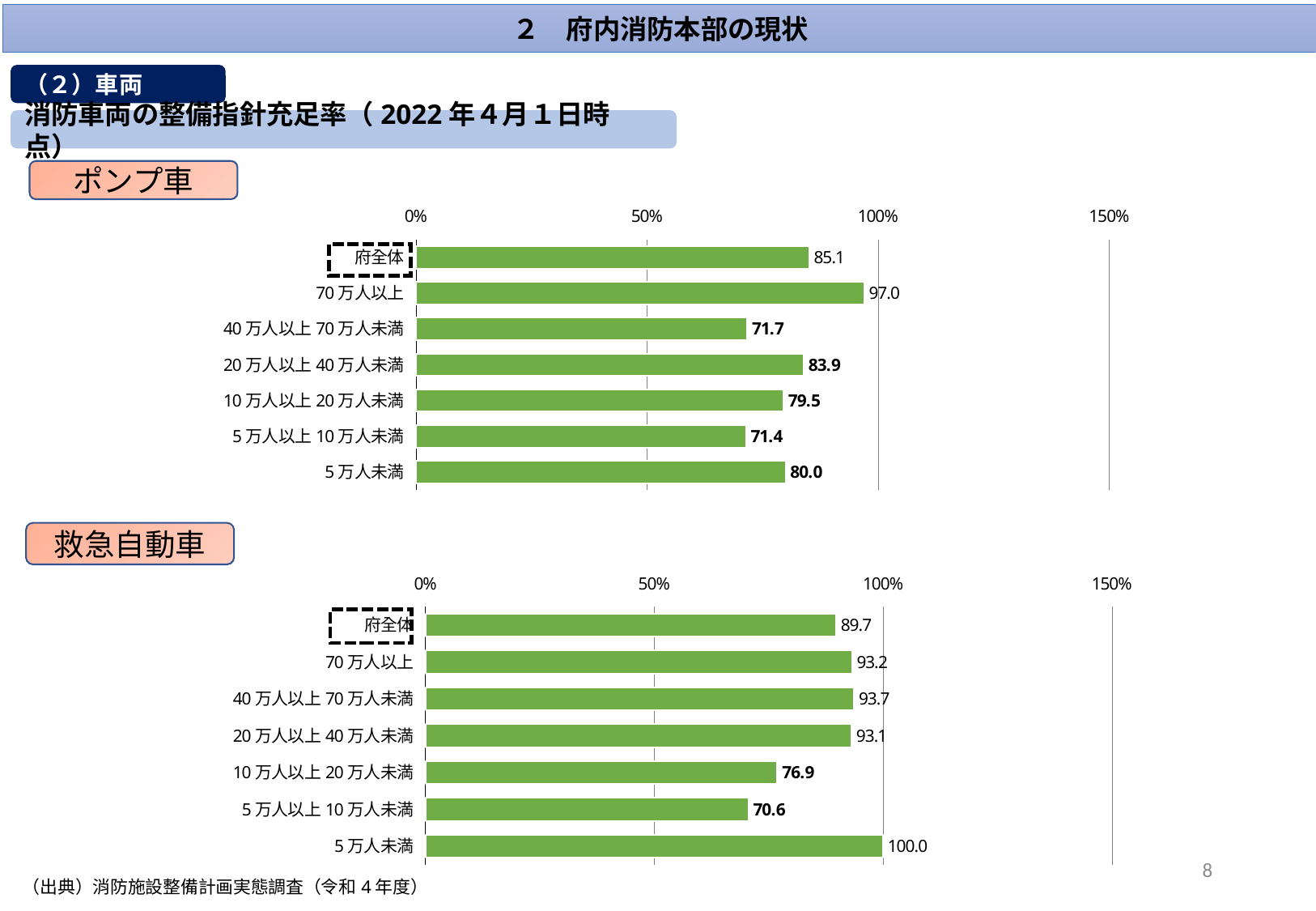
In the 救急自動車 chart, which is larger, the value for 70万人以上 or the value for 10万人以上20万人未満? 70万人以上 In the 救急自動車 chart, what is the value for 5万人未満? 100.0 What kind of chart is the ポンプ車 chart? bar chart In the ポンプ車 chart, how many categories are plotted? 7 What is the highest tick label shown on the x axis of the 救急自動車 chart? 150% In the 救急自動車 chart, what is the difference between the values for 5万人未満 and 府全体? 10.3 In the ポンプ車 chart, what is the difference between the values for 70万人以上 and 府全体? 11.9 In the 救急自動車 chart, is the value for 10万人以上20万人未満 greater or less than 100%? less In the ポンプ車 chart, which category has the lowest value? 5万人以上10万人未満 In the ポンプ車 chart, which category has the highest value? 70万人以上 In the 救急自動車 chart, which category has the lowest value? 5万人以上10万人未満 In the ポンプ車 chart, what is the value for 府全体? 85.1